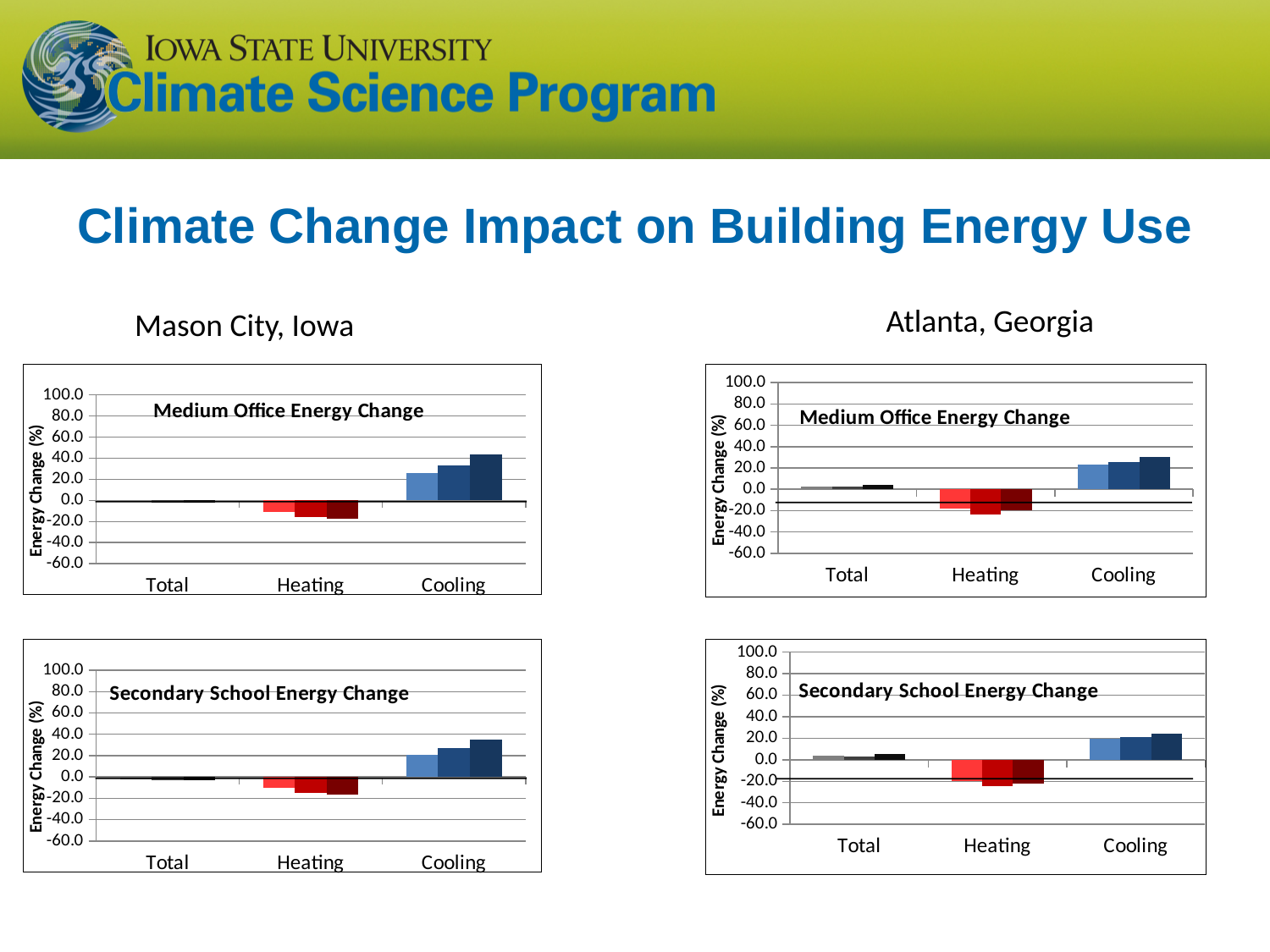
In the Mason City, Iowa Secondary School Energy Change chart, which is larger, the Total values or the Cooling values? Cooling In the Atlanta, Georgia Secondary School Energy Change chart, is the tallest Cooling bar greater or less than 40.0? less What kind of chart is the Mason City, Iowa Medium Office Energy Change chart? bar chart In the Mason City, Iowa Medium Office Energy Change chart, which category has the highest values? Cooling In the Atlanta, Georgia Medium Office Energy Change chart, which is larger, the Cooling values or the Heating values? Cooling What is the y-axis label on the Mason City, Iowa Secondary School Energy Change chart? Energy Change (%) How many categories are shown on the x axis of the Atlanta, Georgia Secondary School Energy Change chart? 3 What is the title of the top chart under Atlanta, Georgia? Medium Office Energy Change In the Atlanta, Georgia Medium Office Energy Change chart, are the Cooling bars greater or less than 0.0? greater In the Atlanta, Georgia Secondary School Energy Change chart, which category has the lowest values? Heating In the Mason City, Iowa Medium Office Energy Change chart, is the tallest Cooling bar greater or less than 20.0? greater